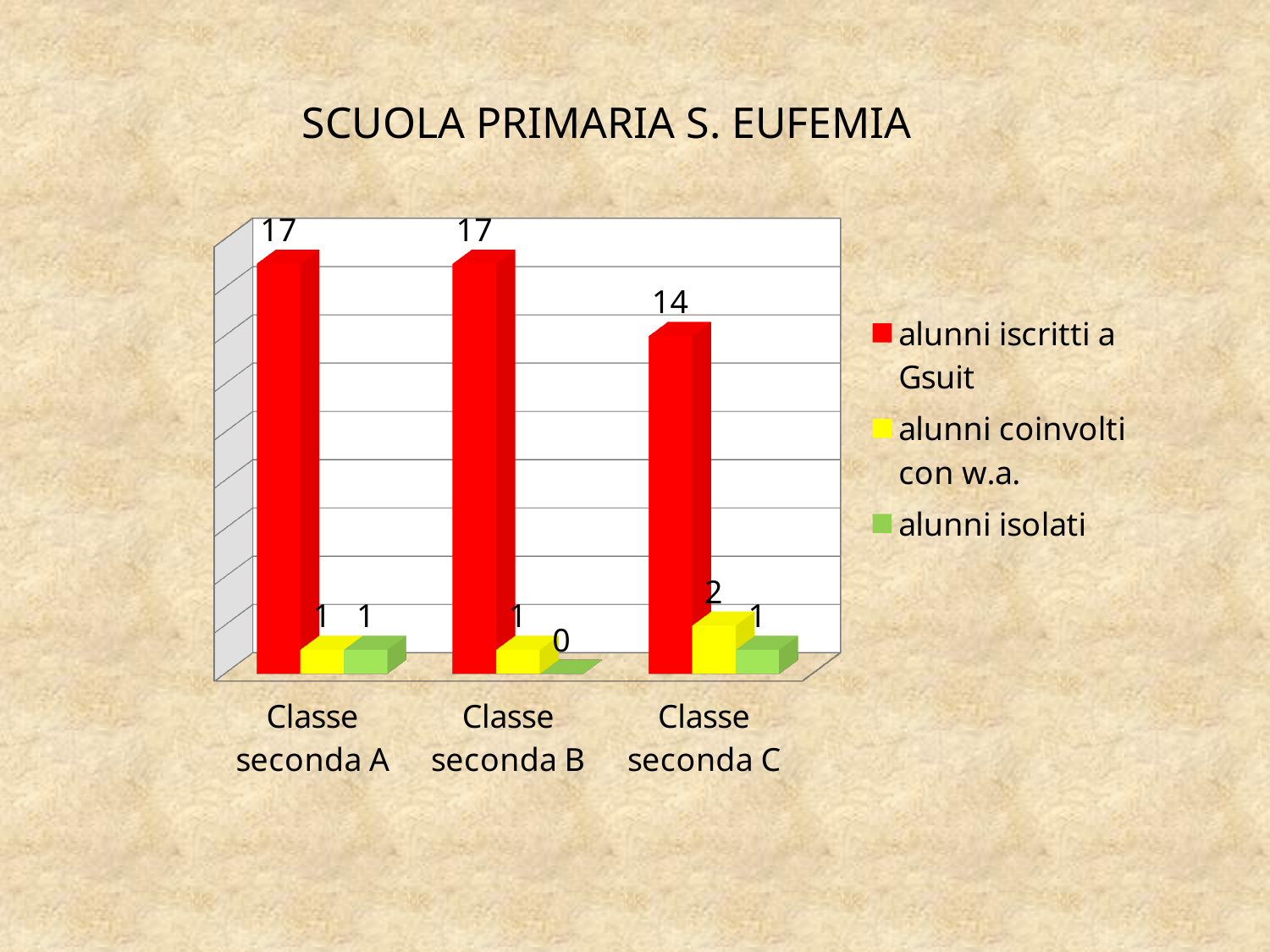
What is the value for 'alunni iscritti a Gsuit' in Classe seconda C? 14 Is the value for 'alunni iscritti a Gsuit' larger in Classe seconda B or in Classe seconda C? Classe seconda B What is the value for 'alunni iscritti a Gsuit' in Classe seconda A? 17 Which class has the lowest value for 'alunni iscritti a Gsuit'? Classe seconda C Which class has the highest value for 'alunni coinvolti con w.a.'? Classe seconda C What is the difference between 'alunni iscritti a Gsuit' in Classe seconda A and in Classe seconda C? 3 Which colour represents 'alunni isolati' in the chart? Green What is the value for 'alunni isolati' in Classe seconda B? 0 What kind of chart is shown on the slide? Bar chart What is the value for 'alunni coinvolti con w.a.' in Classe seconda C? 2 How many classes are shown on the x axis of the chart? 3 How many series does the chart legend list? 3